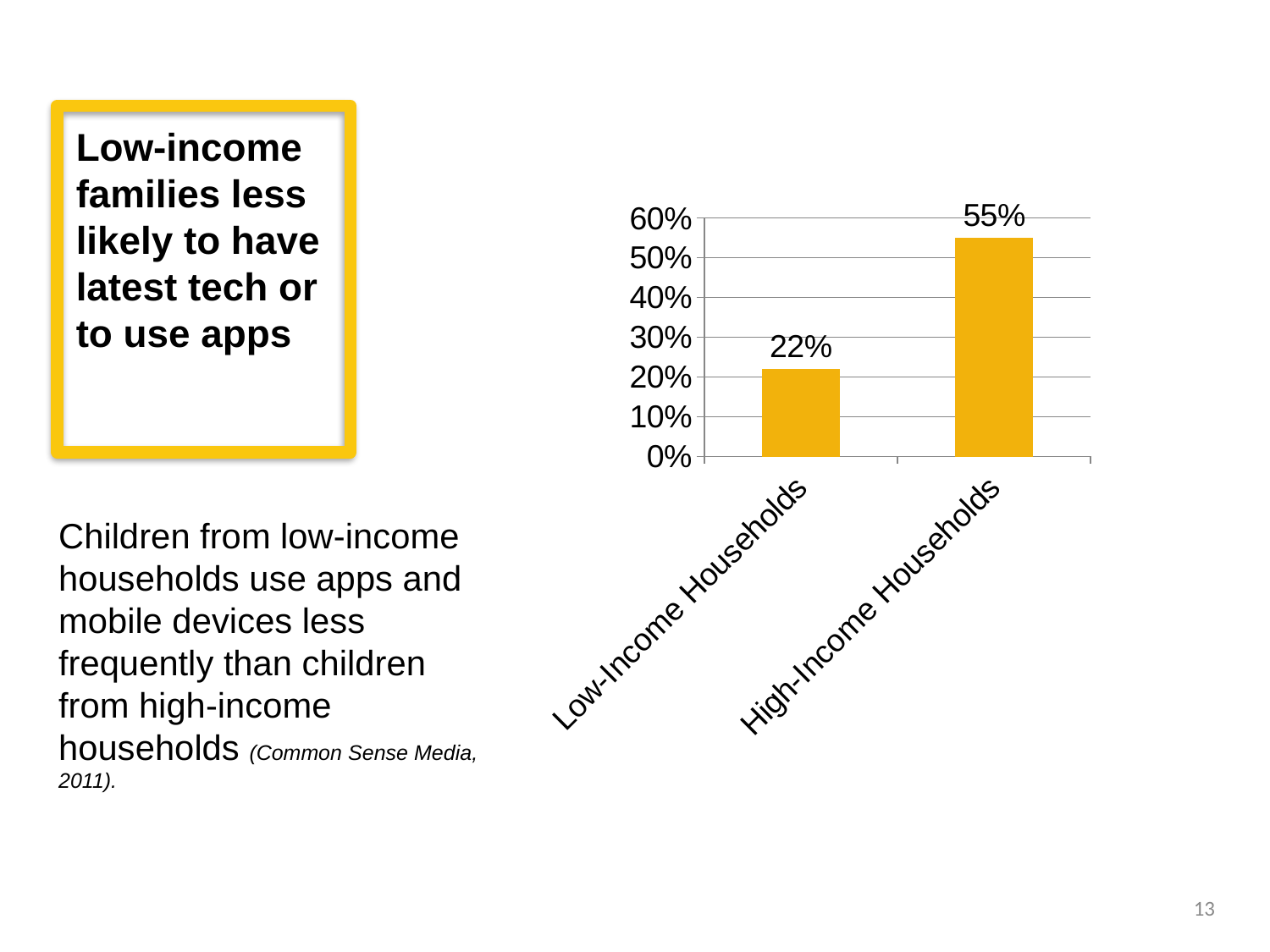
Which is larger, the value for Low-Income Households or the value for High-Income Households? High-Income Households What is the value for High-Income Households? 55% Which category has the highest value? High-Income Households Which category has the lowest value? Low-Income Households What is the difference between the values for High-Income Households and Low-Income Households? 33% Is the value for High-Income Households greater or less than 50%? greater What is the value for Low-Income Households? 22% How many categories are shown on the chart? 2 Is the value for Low-Income Households greater or less than 30%? less What kind of chart is shown on the slide? bar chart What colour are the bars in the chart? yellow What is the highest value shown on the vertical axis of the chart? 60%